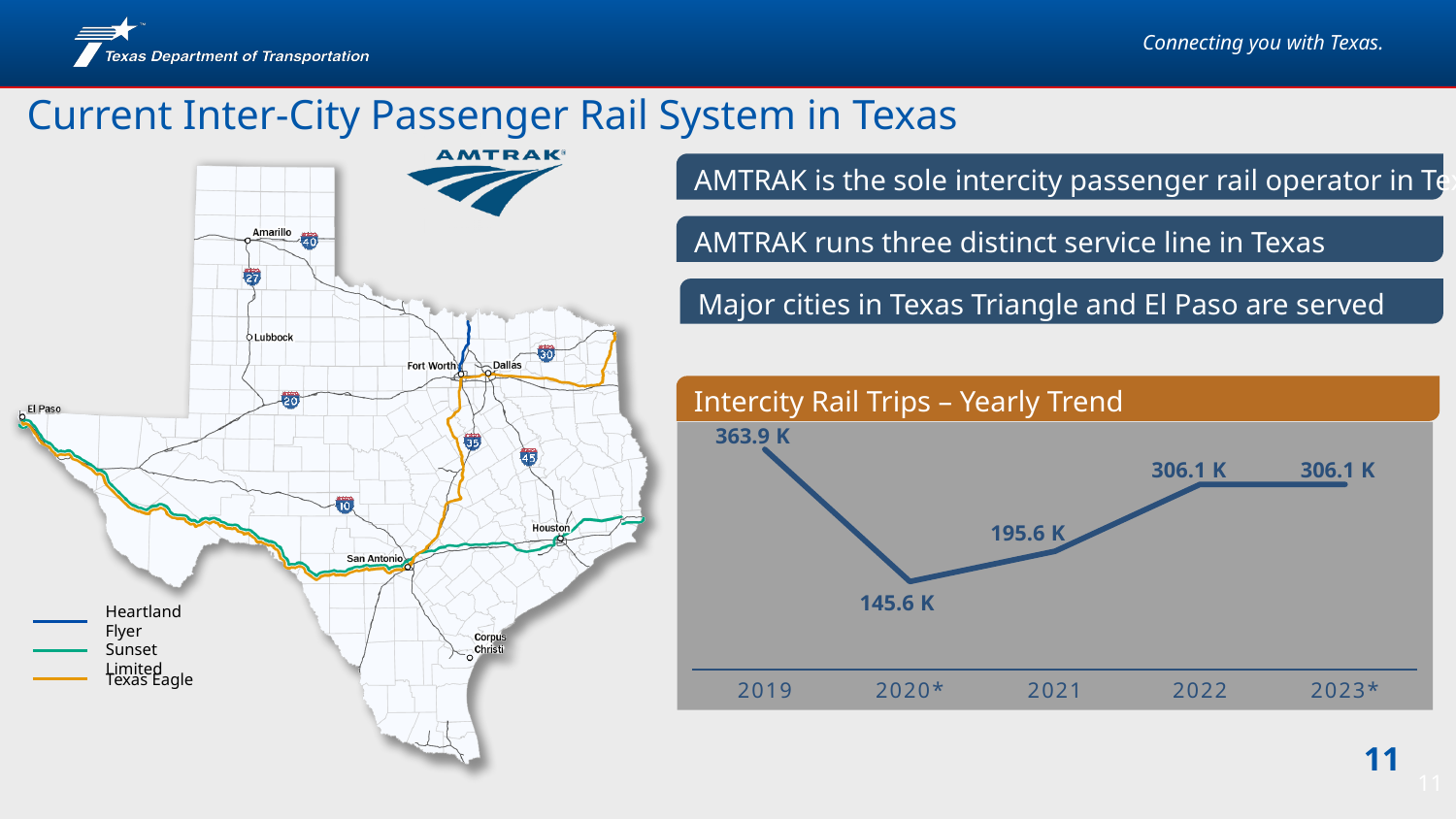
What kind of chart is the Intercity Rail Trips – Yearly Trend chart? Line chart What is the value for 2020* in the Intercity Rail Trips – Yearly Trend chart? 145.6 K What is the value for 2021 in the Intercity Rail Trips – Yearly Trend chart? 195.6 K What is the value for 2019 in the Intercity Rail Trips – Yearly Trend chart? 363.9 K Which year has the lowest value in the Intercity Rail Trips – Yearly Trend chart? 2020* What is the difference between the 2019 and 2020* values in the Intercity Rail Trips – Yearly Trend chart? 218.3 K In the Intercity Rail Trips – Yearly Trend chart, which is larger, the value for 2021 or the value for 2022? 2022 In the Intercity Rail Trips – Yearly Trend chart, do the values rise or fall from 2020* to 2022? Rise What is the value for 2022 in the Intercity Rail Trips – Yearly Trend chart? 306.1 K What is the difference between the 2022 and 2021 values in the Intercity Rail Trips – Yearly Trend chart? 110.5 K Which year has the highest value in the Intercity Rail Trips – Yearly Trend chart? 2019 How many years are plotted in the Intercity Rail Trips – Yearly Trend chart? 5